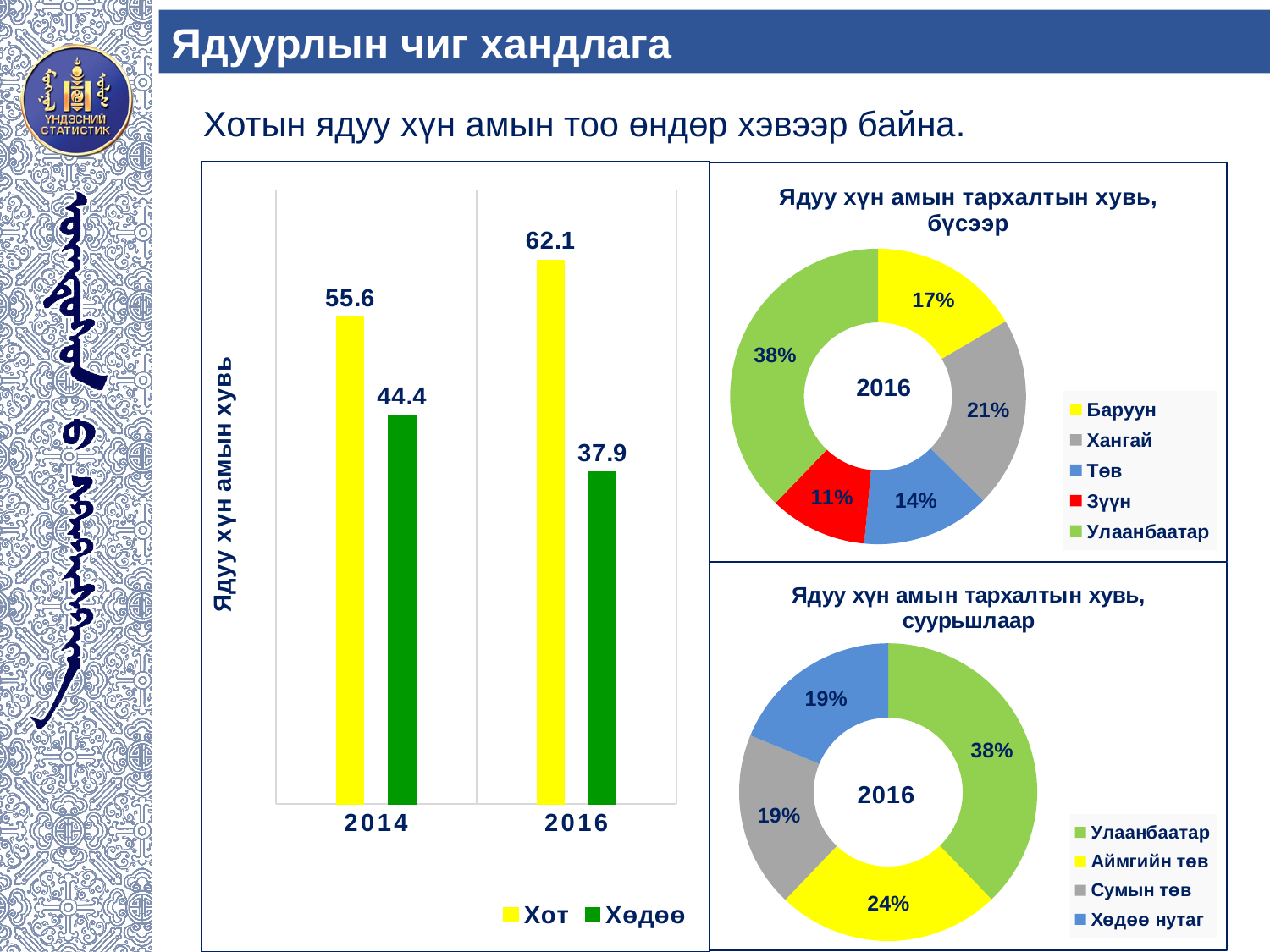
In the chart titled 'Ядуу хүн амын тархалтын хувь, бүсээр', what share does Хангай have? 21% In the chart titled 'Ядуу хүн амын тархалтын хувь, бүсээр', which category has the largest share? Улаанбаатар In the bar chart on the left, what is the value for Хөдөө in 2014? 44.4 In the chart titled 'Ядуу хүн амын тархалтын хувь, суурьшлаар', what share does Аймгийн төв have? 24% In the chart titled 'Ядуу хүн амын тархалтын хувь, суурьшлаар', which is larger, Улаанбаатар or Хөдөө нутаг? Улаанбаатар In the bar chart on the left, what is the difference between Хот and Хөдөө in 2016? 24.2 In the bar chart on the left, what is the value for Хот in 2016? 62.1 In the chart titled 'Ядуу хүн амын тархалтын хувь, бүсээр', how many categories are shown? 5 In the bar chart on the left, did the value for Хөдөө rise or fall from 2014 to 2016? fall What kind of chart is the chart on the left of the slide? bar chart In the bar chart on the left, how many series does the legend list? 2 In the chart titled 'Ядуу хүн амын тархалтын хувь, бүсээр', which category has the smallest share? Зүүн